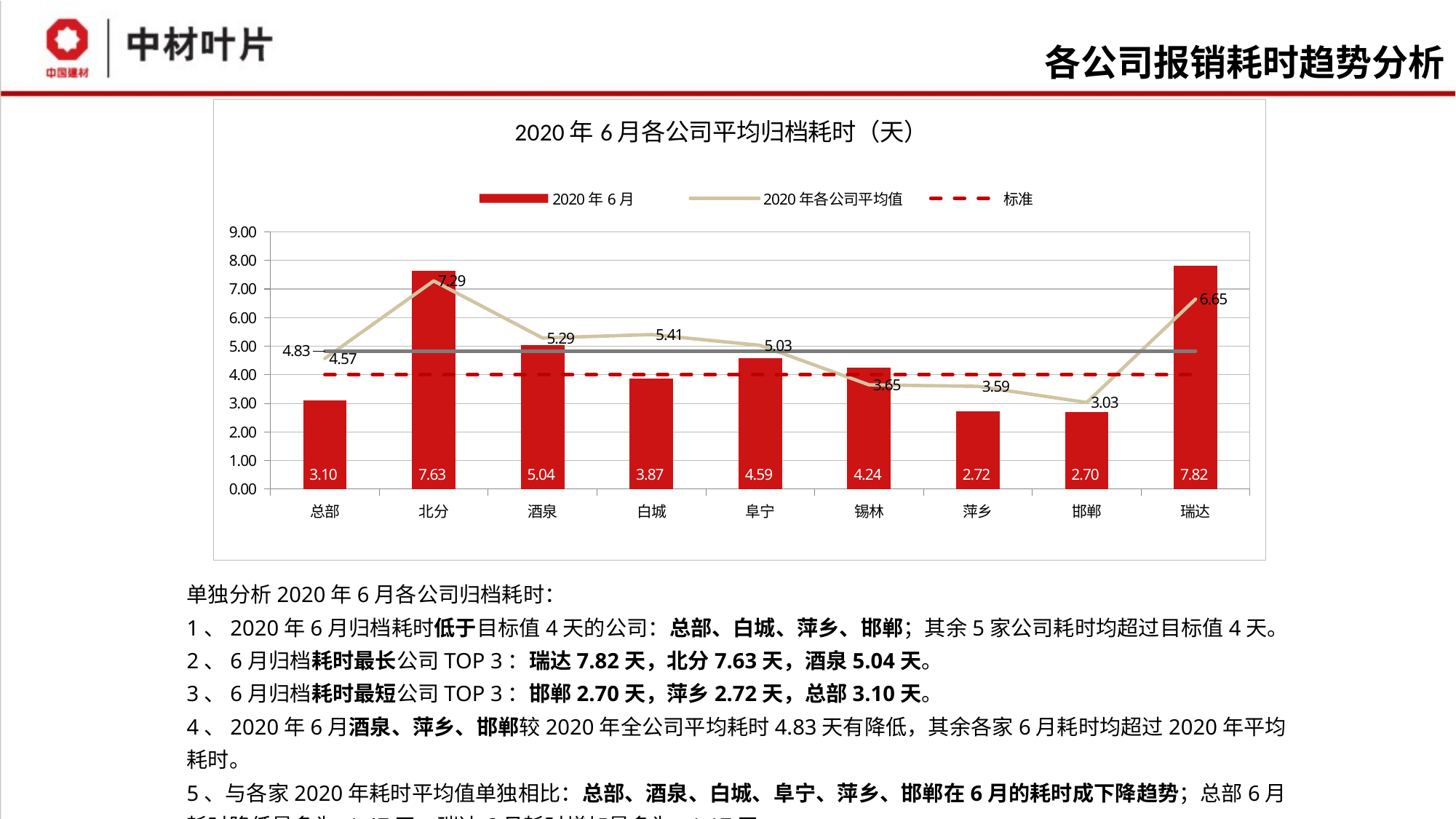
What is the title of the chart? 2020年6月各公司平均归档耗时（天） Which company has the highest 2020年各公司平均值 line value? 北分 How many series does the legend list? 3 Which is larger for 锡林: the 2020年6月 bar or the 2020年各公司平均值 line? 2020年6月 bar Which company has the highest 2020年6月 bar? 瑞达 Is the 2020年6月 value for 阜宁 greater or less than 4.00? greater What is the difference between the 2020年6月 values for 北分 and 酒泉? 2.59 Which company has the lowest 2020年6月 bar? 邯郸 What is the 2020年各公司平均值 value for 白城? 5.41 How many companies are shown on the x axis? 9 What is the 2020年6月 value for 瑞达? 7.82 What kind of chart is this? Combined bar and line chart